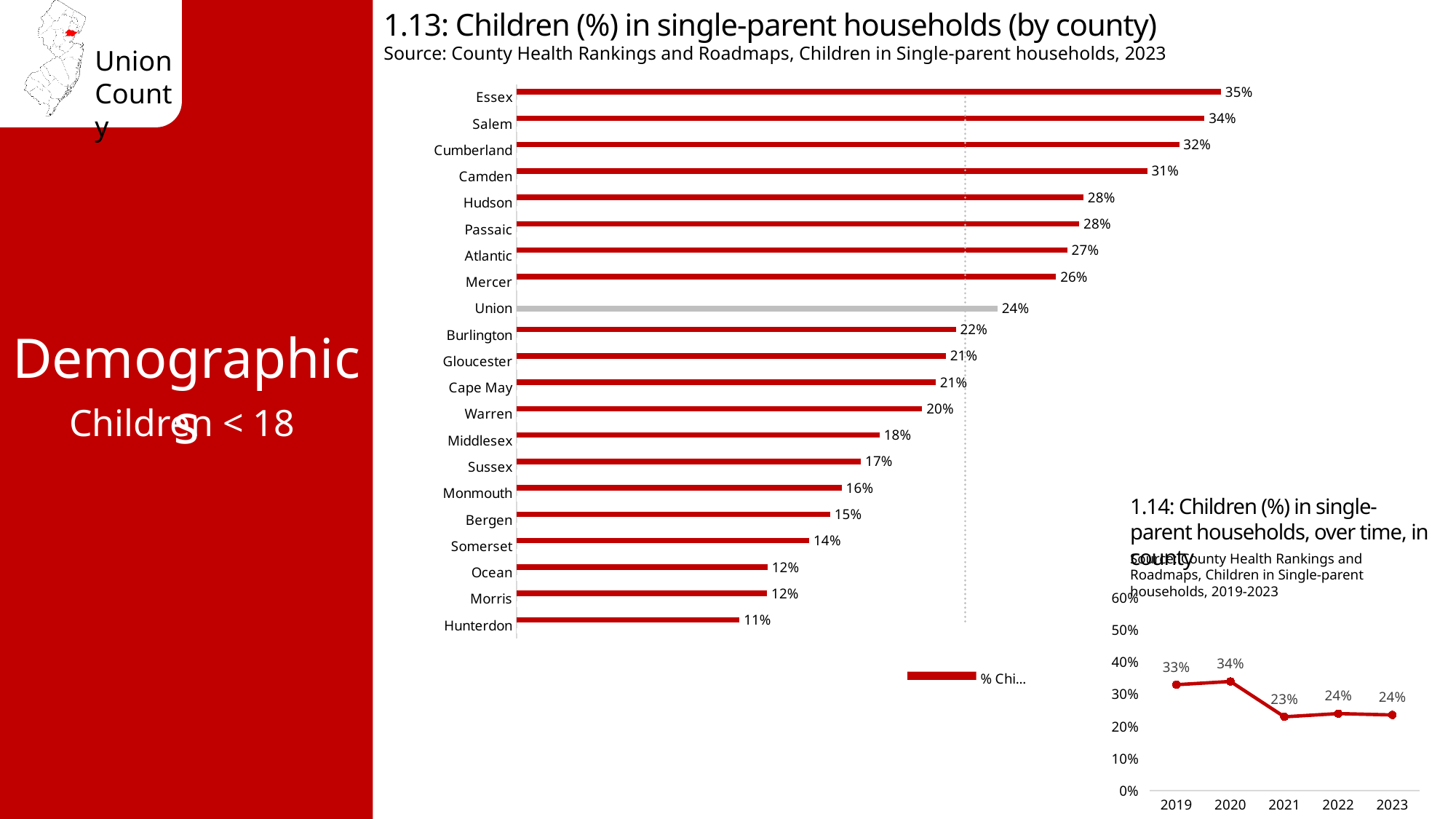
In chart 1.14 (children in single-parent households over time in Union County), what is the value for 2020? 34% In chart 1.13, which county has the highest percentage of children in single-parent households? Essex In chart 1.13, what is the difference between the values for Essex and Union? 11% In chart 1.14, which year has the lowest value? 2021 What kind of chart is chart 1.13? Bar chart In chart 1.13, what is the value for Middlesex? 18% In chart 1.13 (children in single-parent households by county), what is the value for Union? 24% In chart 1.13, which county has the lowest percentage of children in single-parent households? Hunterdon In chart 1.13, which county has a larger value, Camden or Hudson? Camden In chart 1.13, how many counties are shown? 21 What kind of chart is chart 1.14? Line chart In chart 1.14, what is the difference between the values for 2020 and 2021? 11%